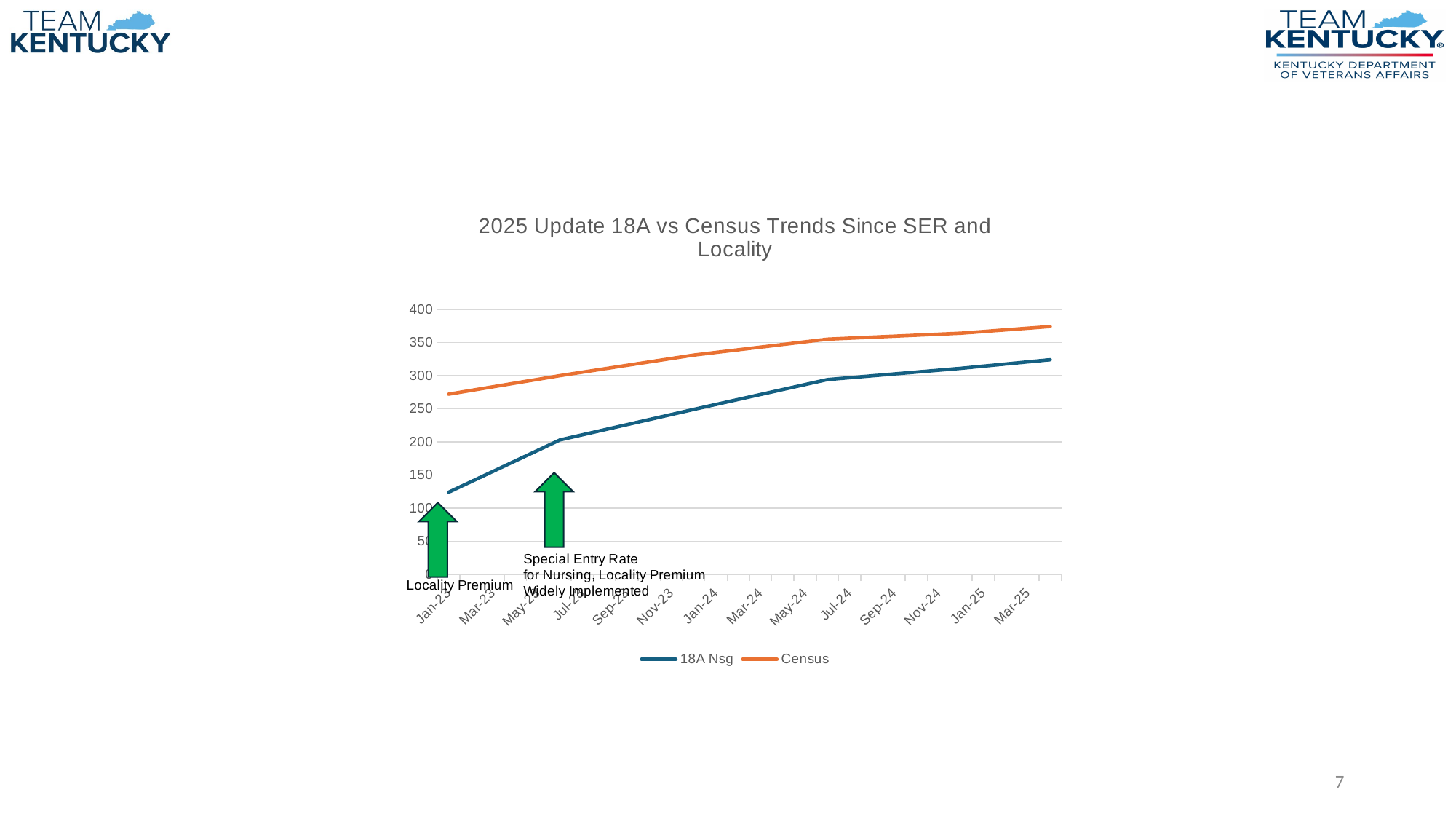
What kind of chart is shown on the slide? Line chart At Jan-23, which series has the higher value, 18A Nsg or Census? Census What is the title of the chart? 2025 Update 18A vs Census Trends Since SER and Locality Does the 18A Nsg line rise or fall from Jan-23 to Mar-25? Rises Is the value for Census at Mar-25 greater or less than 350? greater How many series does the legend list? 2 Which series is drawn in orange? Census Is the value for 18A Nsg at Jul-23 greater or less than 150? greater Is the value for 18A Nsg at Jan-23 greater or less than 150? less How many date labels are shown on the x axis? 14